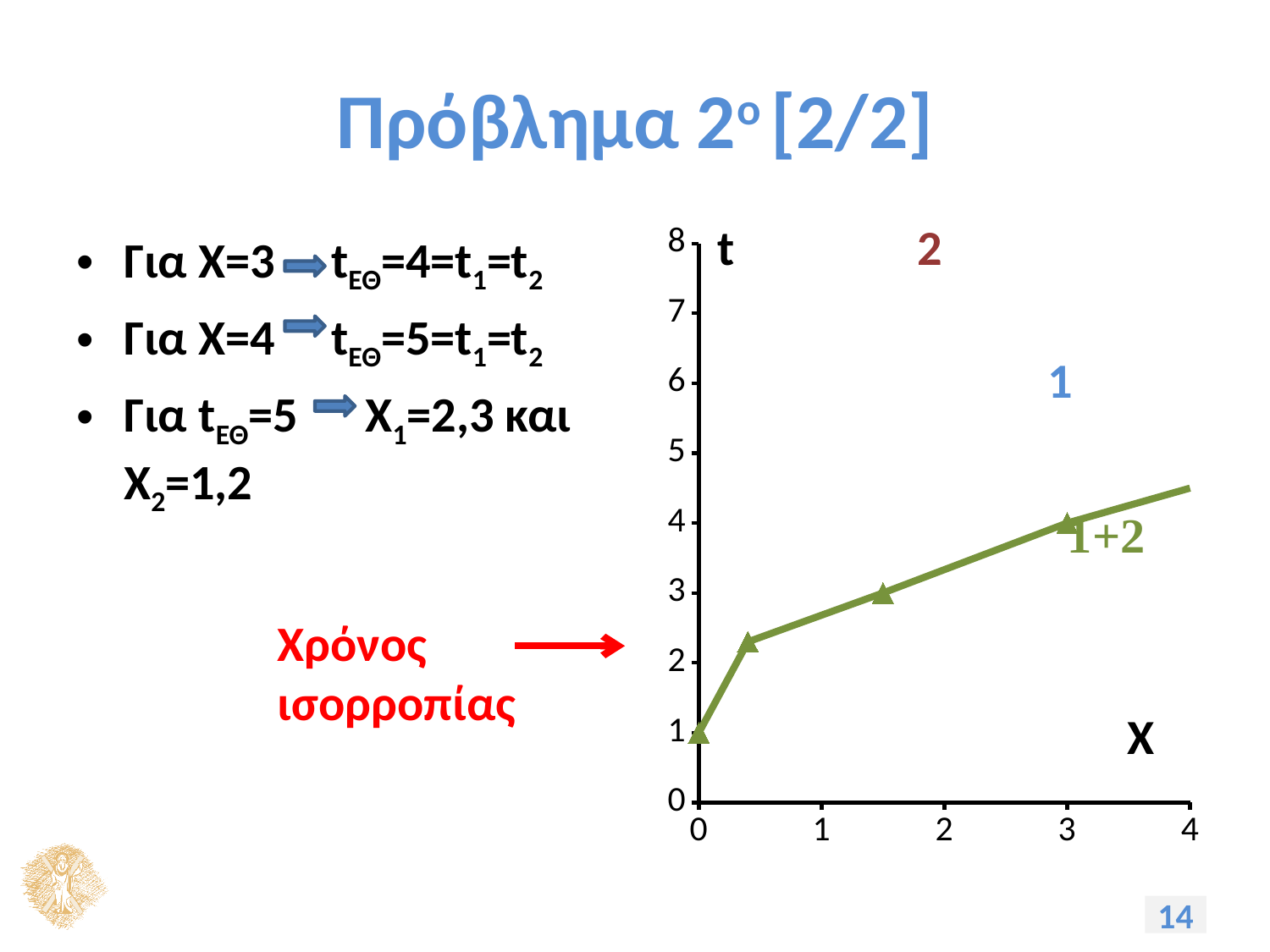
Is the value of t at X=2 greater or less than 4? less Is the value of t at X=4 greater or less than 4? greater What kind of chart is shown on the slide? line chart What is the value of t at X=3 on the chart? 4 What is the highest value shown on the vertical (t) axis? 8 What is the difference between t at X=3 and t at X=0? 3 Which has the larger t value: the point at X=3 or the point at X=0? X=3 What is the value of t at X=0 on the chart? 1 Does the value of t rise or fall as X increases along the x axis? rise How many triangle data markers are plotted on the line? 4 What label is written next to the horizontal axis of the chart? X